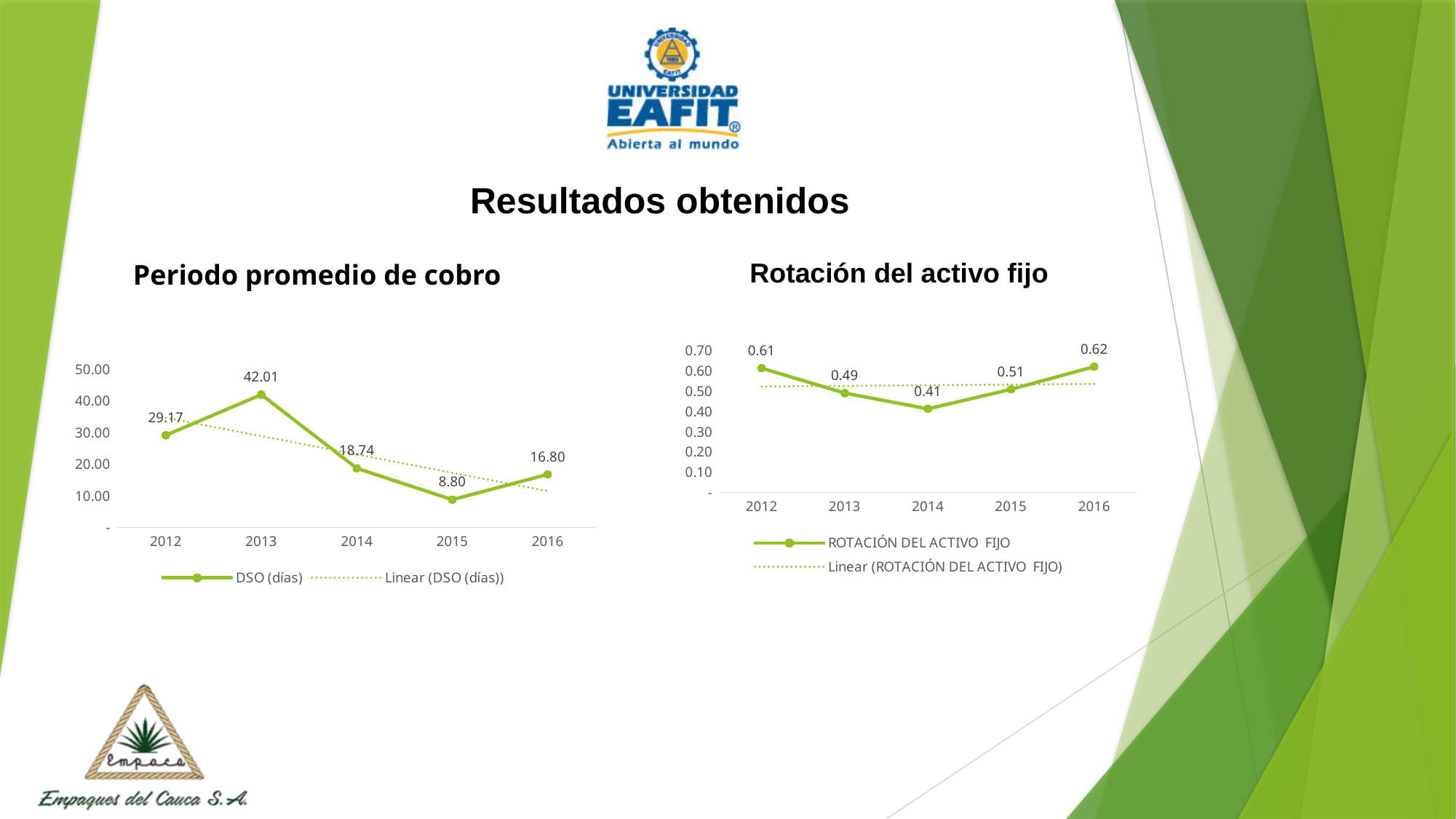
In the 'Rotación del activo fijo' chart, is the value for 2013 larger or smaller than the value for 2015? smaller In the 'Periodo promedio de cobro' chart, which year has the lowest DSO (días) value? 2015 In the 'Periodo promedio de cobro' chart, what is the difference between the DSO (días) values for 2013 and 2012? 12.84 In the 'Periodo promedio de cobro' chart, which year has the highest DSO (días) value? 2013 In the 'Rotación del activo fijo' chart, what is the value for 2016? 0.62 In the 'Rotación del activo fijo' chart, what is the value for 2014? 0.41 In the 'Periodo promedio de cobro' chart, what is the DSO (días) value for 2013? 42.01 In the 'Rotación del activo fijo' chart, which year has the lowest value? 2014 What type of chart is the 'Rotación del activo fijo' chart? Line chart In the 'Periodo promedio de cobro' chart, what is the DSO (días) value for 2015? 8.80 In the 'Periodo promedio de cobro' chart, how many years are plotted on the x axis? 5 In the 'Rotación del activo fijo' chart, what is the difference between the values for 2016 and 2014? 0.21